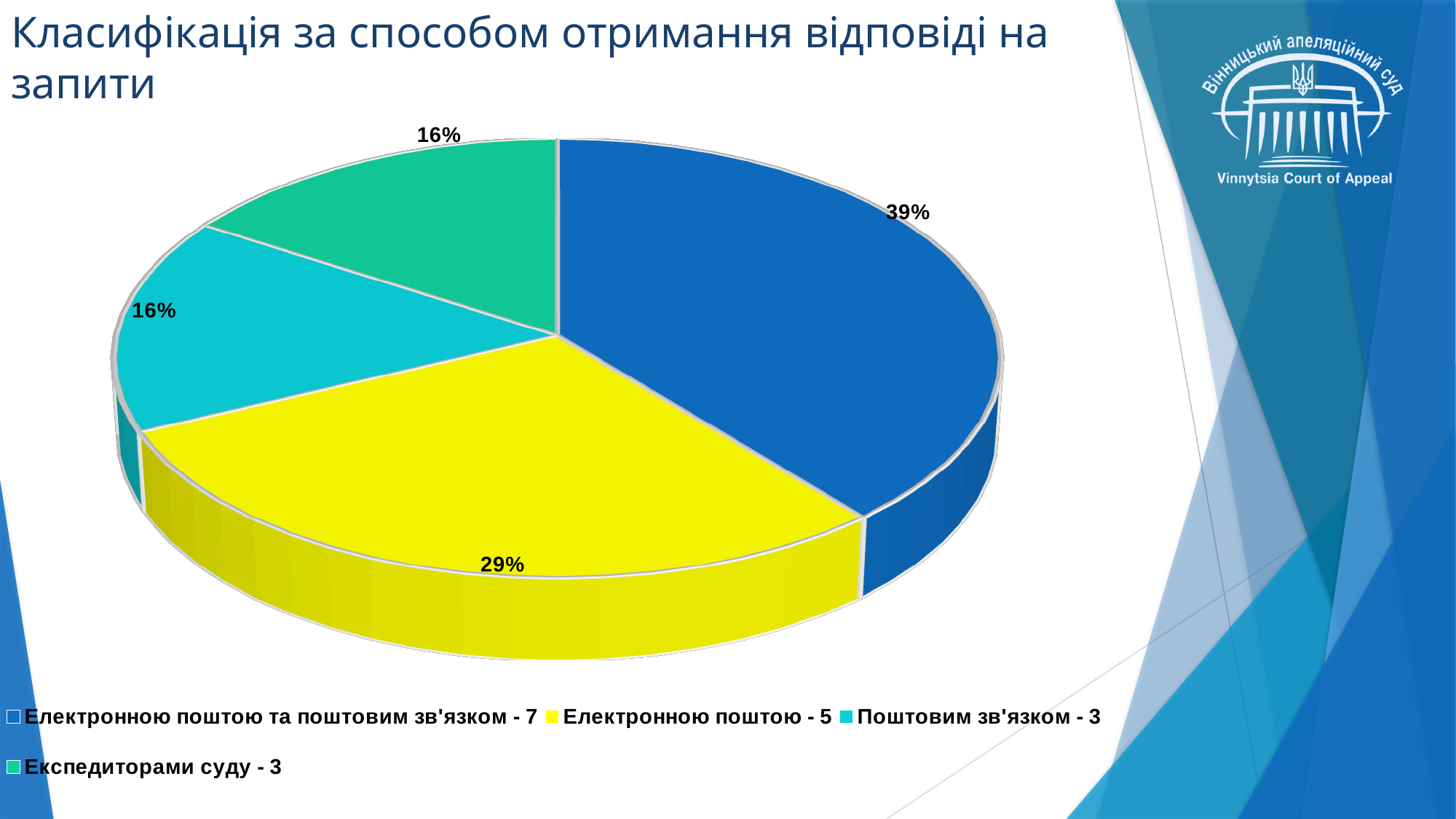
What share of the pie does the slice for "Електронною поштою" represent? 29% What is the difference in percentage points between the "Електронною поштою та поштовим зв'язком" slice and the "Електронною поштою" slice? 10 percentage points What share of the pie does the slice for "Експедиторами суду" represent? 16% What share of the pie does the slice for "Поштовим зв'язком" represent? 16% What kind of chart is shown on the slide? pie chart According to the legend, how many requests were answered "Електронною поштою та поштовим зв'язком"? 7 According to the legend, how many requests were answered "Експедиторами суду"? 3 How many slices does the pie chart have? 4 Which category has the largest slice of the pie? Електронною поштою та поштовим зв'язком Which slice is larger: "Електронною поштою" or "Поштовим зв'язком"? Електронною поштою What colour is the slice for "Електронною поштою"? yellow